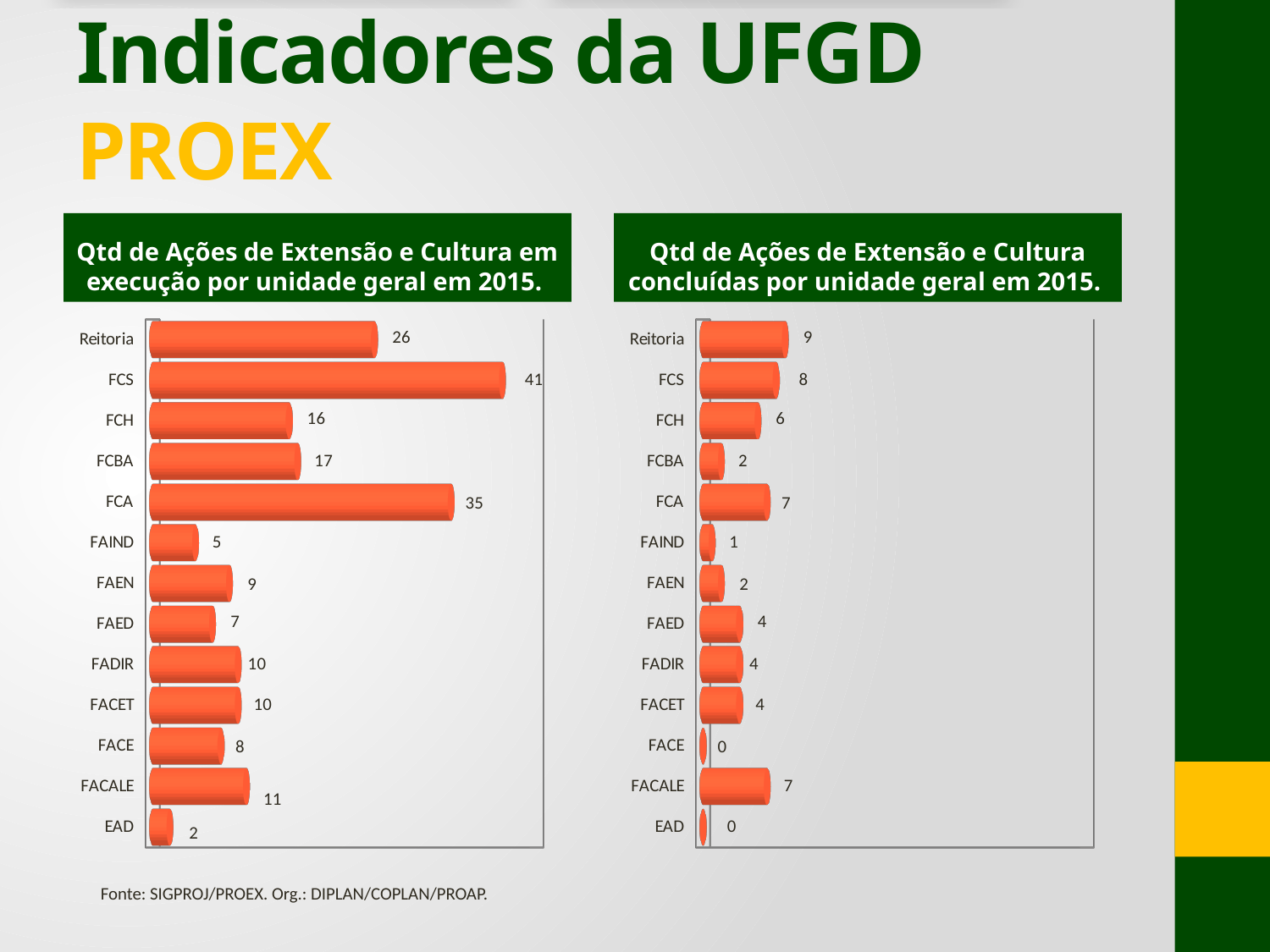
In the left chart (ações em execução), which is larger, the value for Reitoria or the value for FCBA? Reitoria In the right chart (ações concluídas), what is the value for FCH? 6 In the left chart (ações em execução), which unit has the highest value? FCS In the right chart (ações concluídas), which unit has the highest value? Reitoria In the left chart (ações em execução), what is the difference between the values for FCS and FCA? 6 In the left chart (ações em execução), what is the value for FCS? 41 In the right chart (ações concluídas), what is the difference between the values for Reitoria and FCBA? 7 In the left chart (ações em execução), which unit has the lowest value? EAD What is the title of the left chart? Qtd de Ações de Extensão e Cultura em execução por unidade geral em 2015. In the right chart (ações concluídas), which is larger, the value for FCA or the value for FAED? FCA How many units are listed in the left chart (ações em execução)? 13 What type of chart is the right chart (ações concluídas)? Bar chart